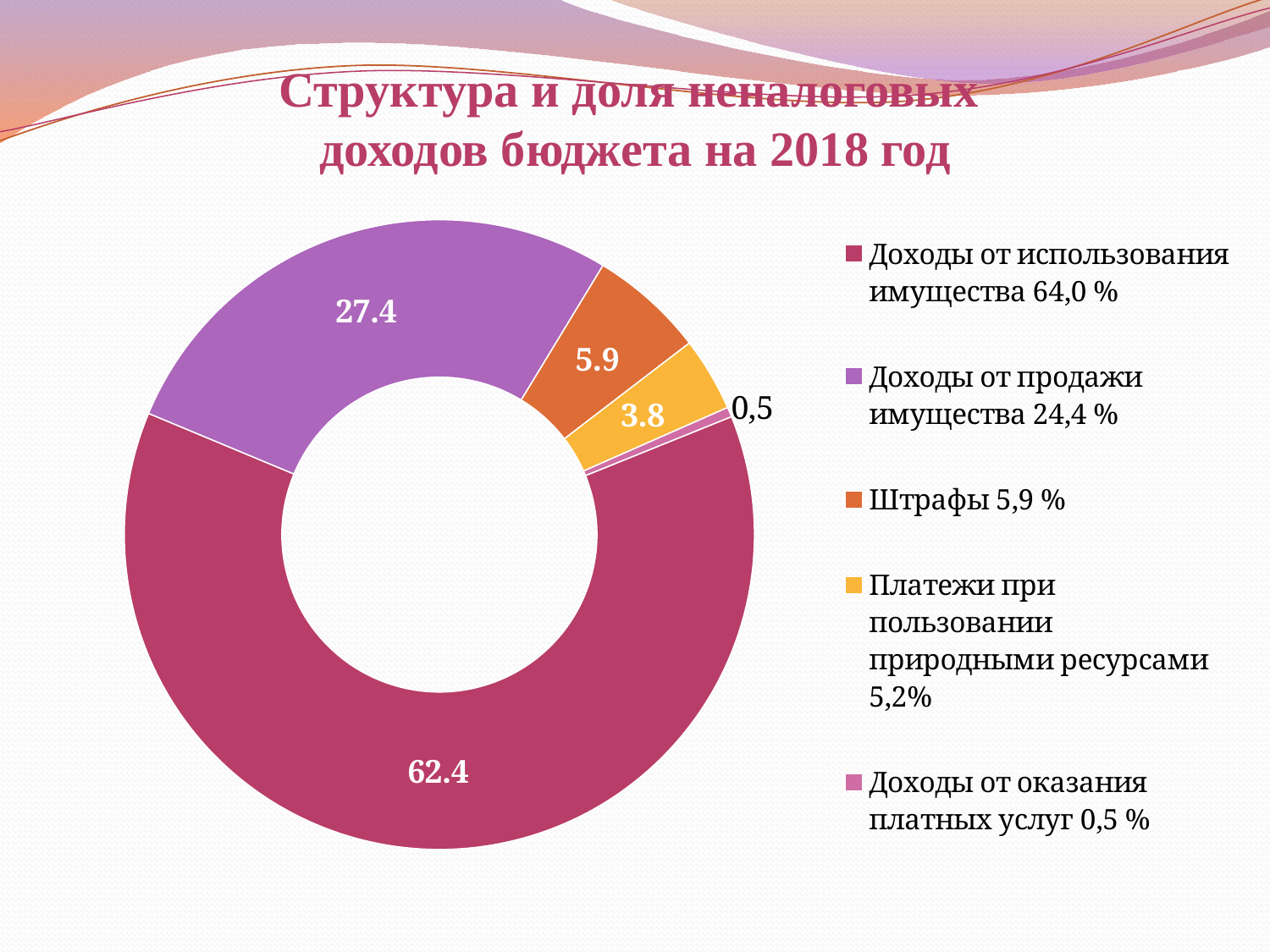
What colour is the slice for Штрафы? orange What kind of chart is shown on the slide? doughnut chart What is the difference between the data labels for Доходы от использования имущества (62.4) and Доходы от продажи имущества (27.4)? 35.0 What data label is printed on the slice for Доходы от использования имущества? 62.4 What data label is printed on the slice for Доходы от продажи имущества? 27.4 What data label is printed on the slice for Доходы от оказания платных услуг? 0,5 What data label is printed on the slice for Платежи при пользовании природными ресурсами? 3.8 Which category has the largest slice in the chart? Доходы от использования имущества How many categories (slices) does the chart have? 5 Which slice is larger: Штрафы or Платежи при пользовании природными ресурсами? Штрафы What data label is printed on the slice for Штрафы? 5.9 Which category has the smallest slice in the chart? Доходы от оказания платных услуг